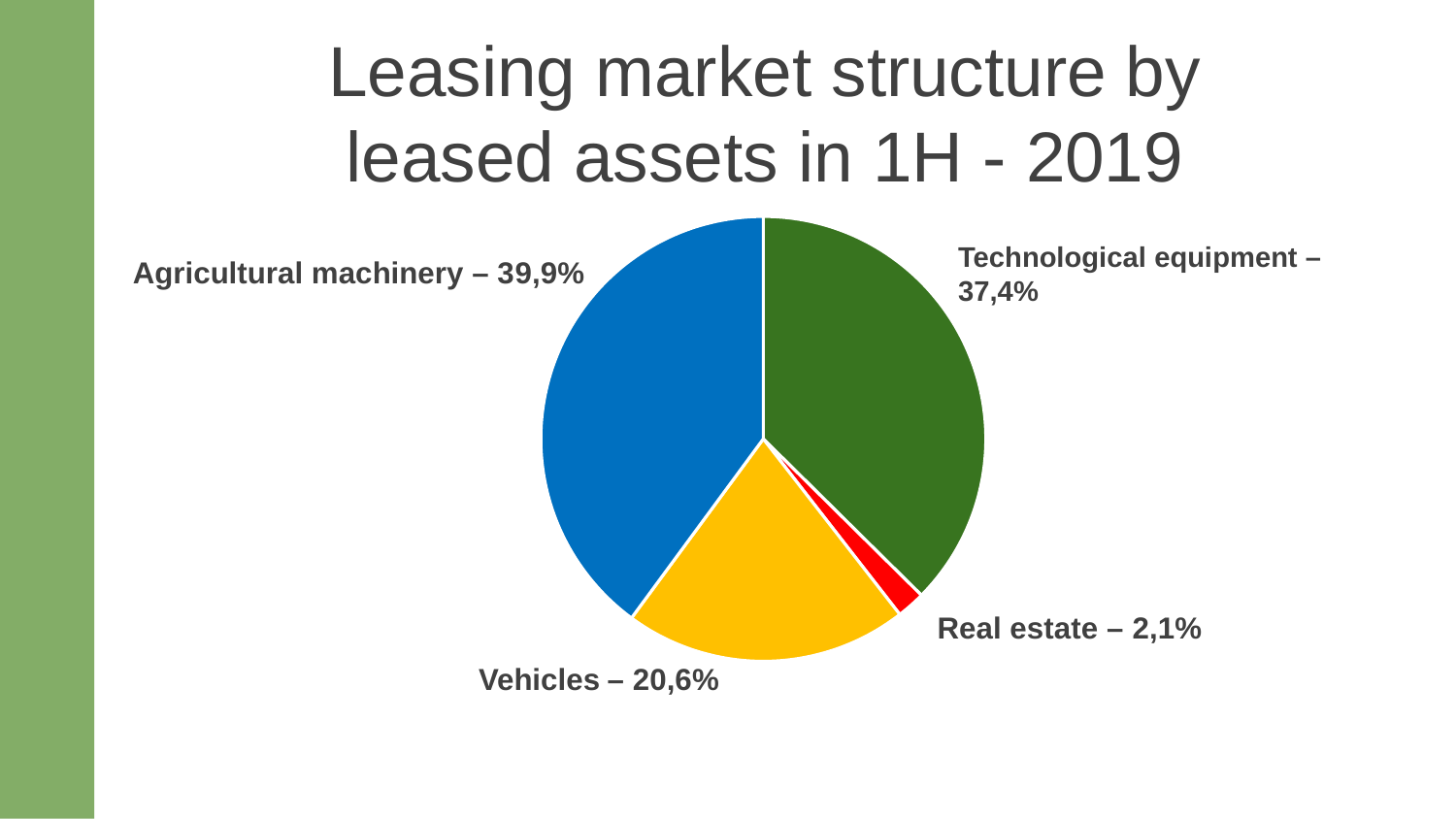
What is the difference in percentage points between Agricultural machinery and Technological equipment? 2,5 What is the title of the chart on the slide? Leasing market structure by leased assets in 1H - 2019 What type of chart is shown on the slide? pie chart What share of leased assets is Real estate? 2,1% Which category has the largest share of the pie? Agricultural machinery What share of leased assets is Vehicles? 20,6% What share of leased assets is Agricultural machinery? 39,9% What is the difference in percentage points between Vehicles and Real estate? 18,5 Which category has the smallest share of the pie? Real estate Which is larger, the share for Vehicles or the share for Real estate? Vehicles How many categories are shown in the pie chart? 4 What share of leased assets is Technological equipment? 37,4%